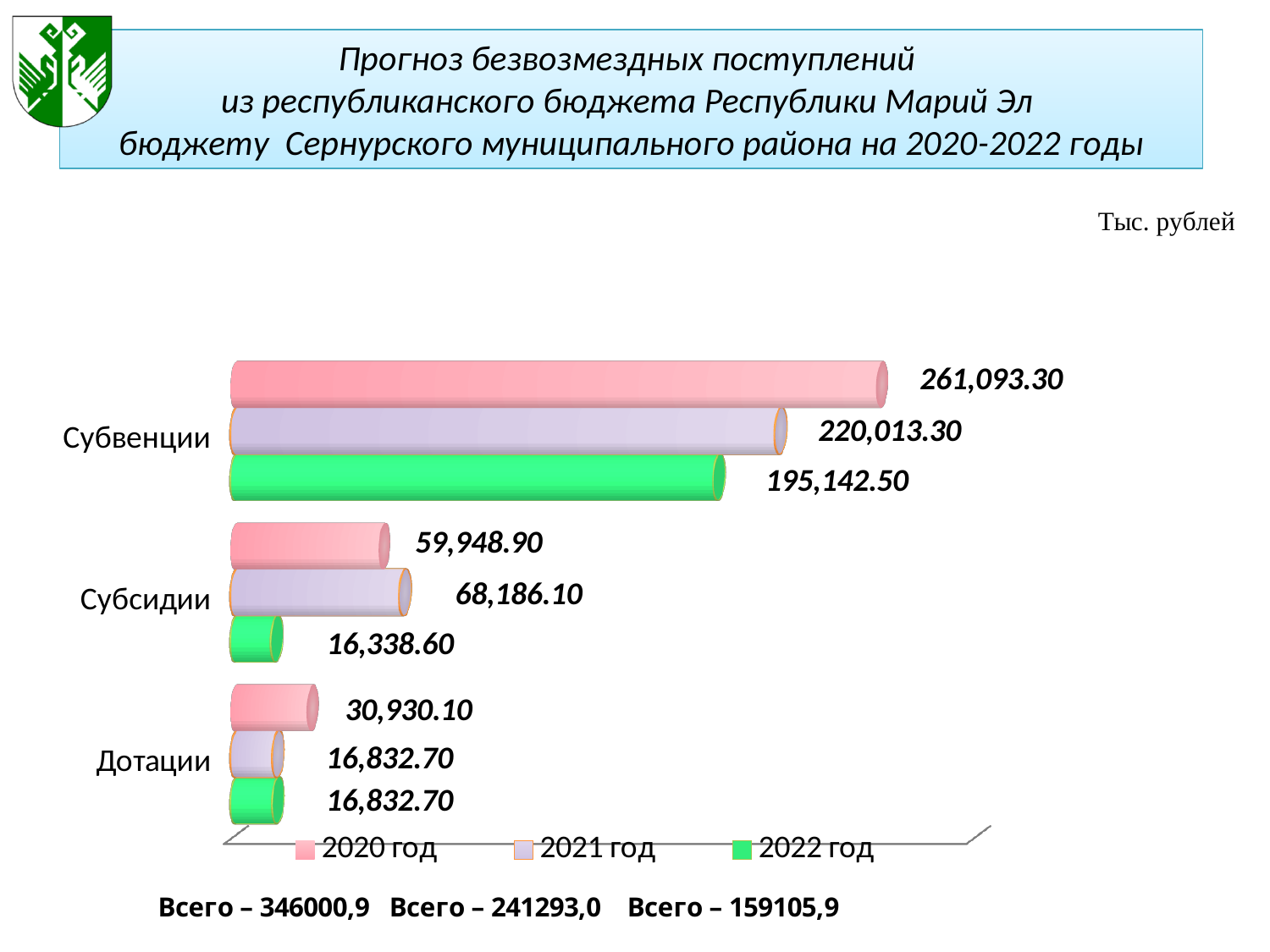
What is the difference between the 2021 год and 2020 год values for Субсидии? 8,237.20 What kind of chart is shown on the slide? Bar chart Which category has the lowest value in the 2020 год series? Дотации What is the value for Субвенции in the 2020 год series? 261,093.30 How many categories are shown on the chart? 3 What is the difference between the 2020 год and 2021 год values for Субвенции? 41,080.00 Which category has the highest value in the 2022 год series? Субвенции What is the value for Субсидии in the 2022 год series? 16,338.60 How many series does the legend list? 3 For Субсидии, which is larger: the 2020 год value or the 2021 год value? 2021 год What is the value for Субвенции in the 2021 год series? 220,013.30 What is the value for Дотации in the 2020 год series? 30,930.10